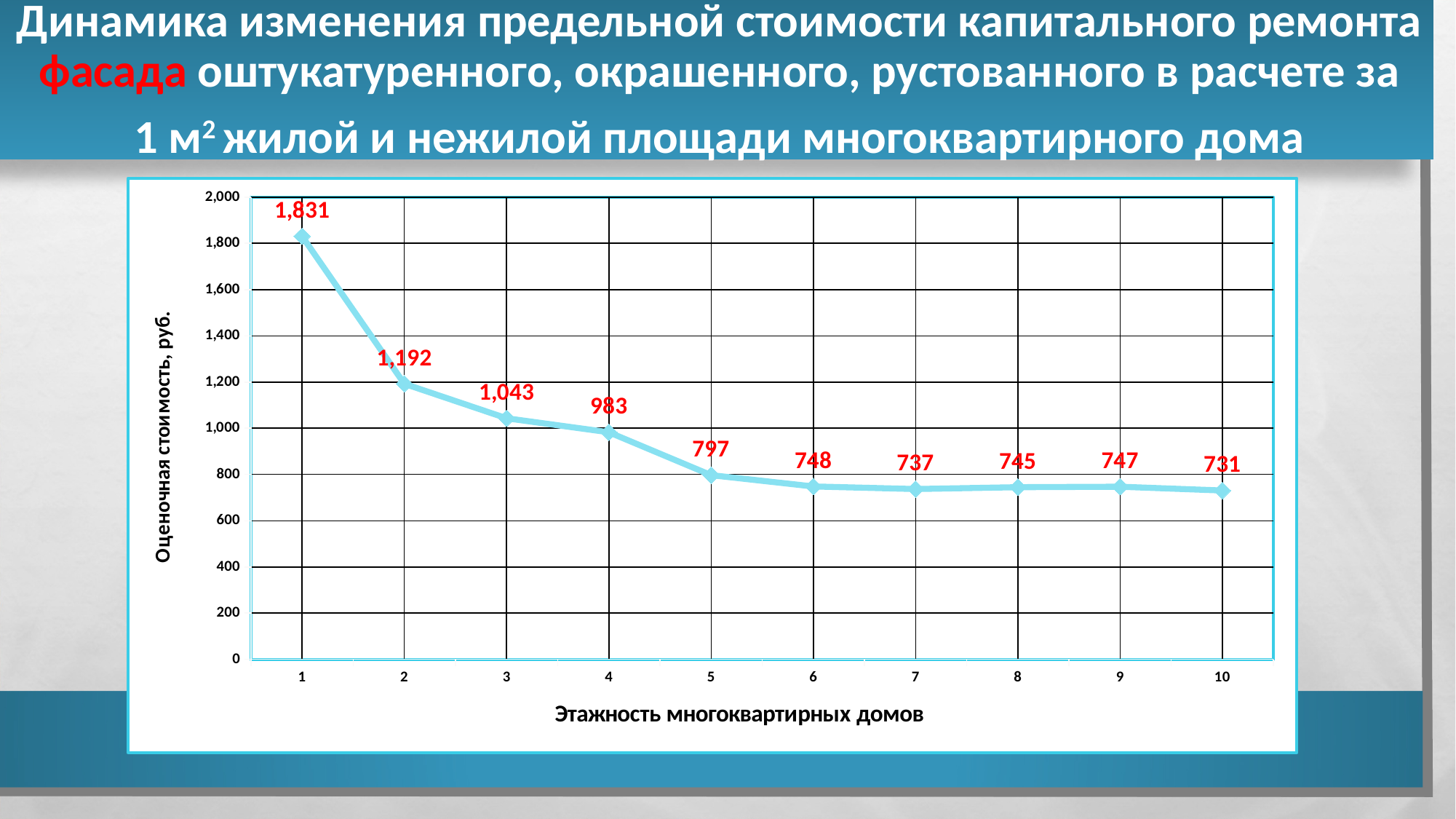
What is the difference between the estimated cost for 1 storey and for 2 storeys? 639 What type of chart is shown on the slide? line chart Is the estimated cost for a 2-storey building greater or less than 1,000? greater Which number of storeys has the highest estimated cost? 1 Which has a higher estimated cost: 3 storeys or 4 storeys? 3 storeys What is the estimated cost for a 1-storey building? 1,831 What is the estimated cost for a 5-storey building? 797 Does the estimated cost rise or fall as the number of storeys increases from 1 to 6? fall What is the estimated cost for a 10-storey building? 731 Which number of storeys has the lowest estimated cost? 10 How many data points are plotted on the chart? 10 What is the difference between the estimated cost for 4 storeys and for 5 storeys? 186